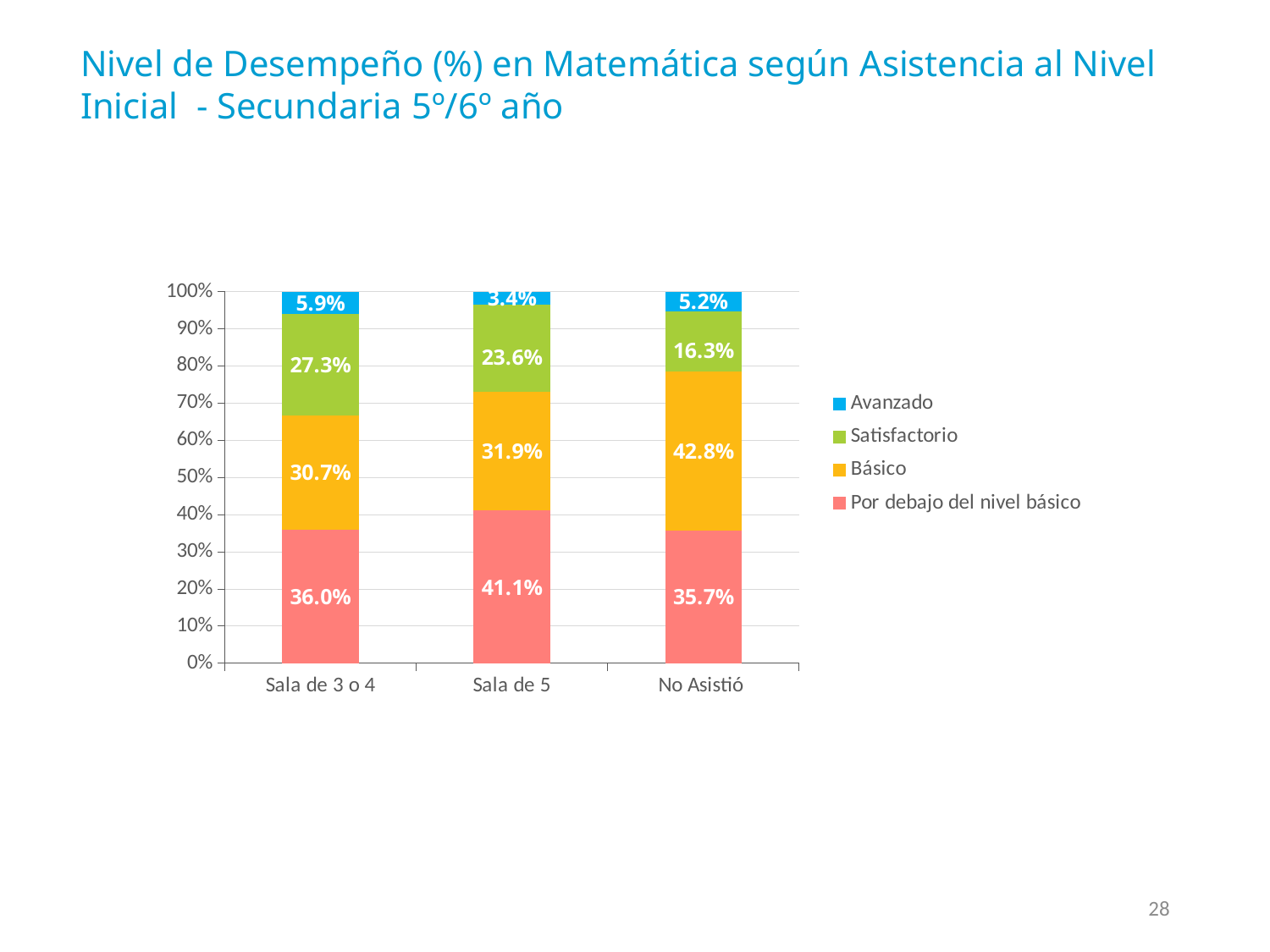
Which category has the lowest value for Avanzado? Sala de 5 How many series does the legend list? 4 What is the difference between the Básico values for No Asistió and Sala de 3 o 4? 12.1% Which category has the highest value for Básico? No Asistió Which is larger: Por debajo del nivel básico for Sala de 5 or for No Asistió? Sala de 5 What kind of chart is shown on the slide? Stacked bar chart What is the value for Básico in the Sala de 5 category? 31.9% What is the difference between the Satisfactorio values for Sala de 3 o 4 and No Asistió? 11.0% What is the value for Por debajo del nivel básico in the Sala de 3 o 4 category? 36.0% How many categories are shown on the x axis? 3 Which series is shown in blue in the legend? Avanzado What is the value for Avanzado in the No Asistió category? 5.2%